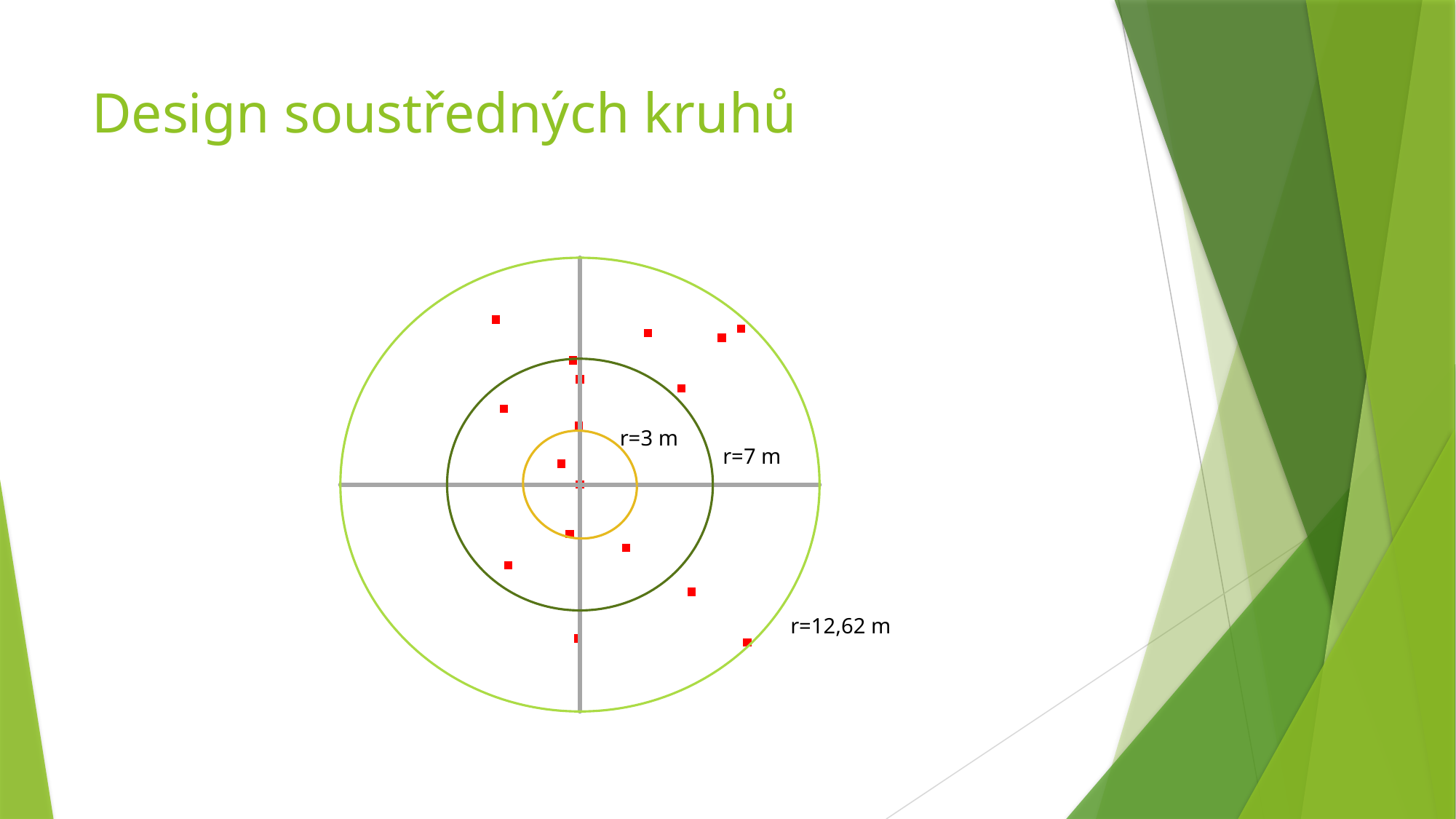
How many concentric circles are drawn on the chart? 3 What is the radius of the outermost circle? r=12,62 m What kind of chart is shown on the slide? scatter chart What is the radius of the innermost circle? r=3 m What is the title of the slide containing the chart? Design soustředných kruhů Which is larger, the radius of the middle circle or the radius of the innermost circle? the middle circle (r=7 m) What colour are the plotted points on the chart? red What is the radius of the middle circle? r=7 m Which circle has the smallest radius? r=3 m What is the difference between the radius of the middle circle and the innermost circle? 4 m What is the difference between the radius of the outermost circle and the middle circle? 5,62 m Which circle has the largest radius? r=12,62 m